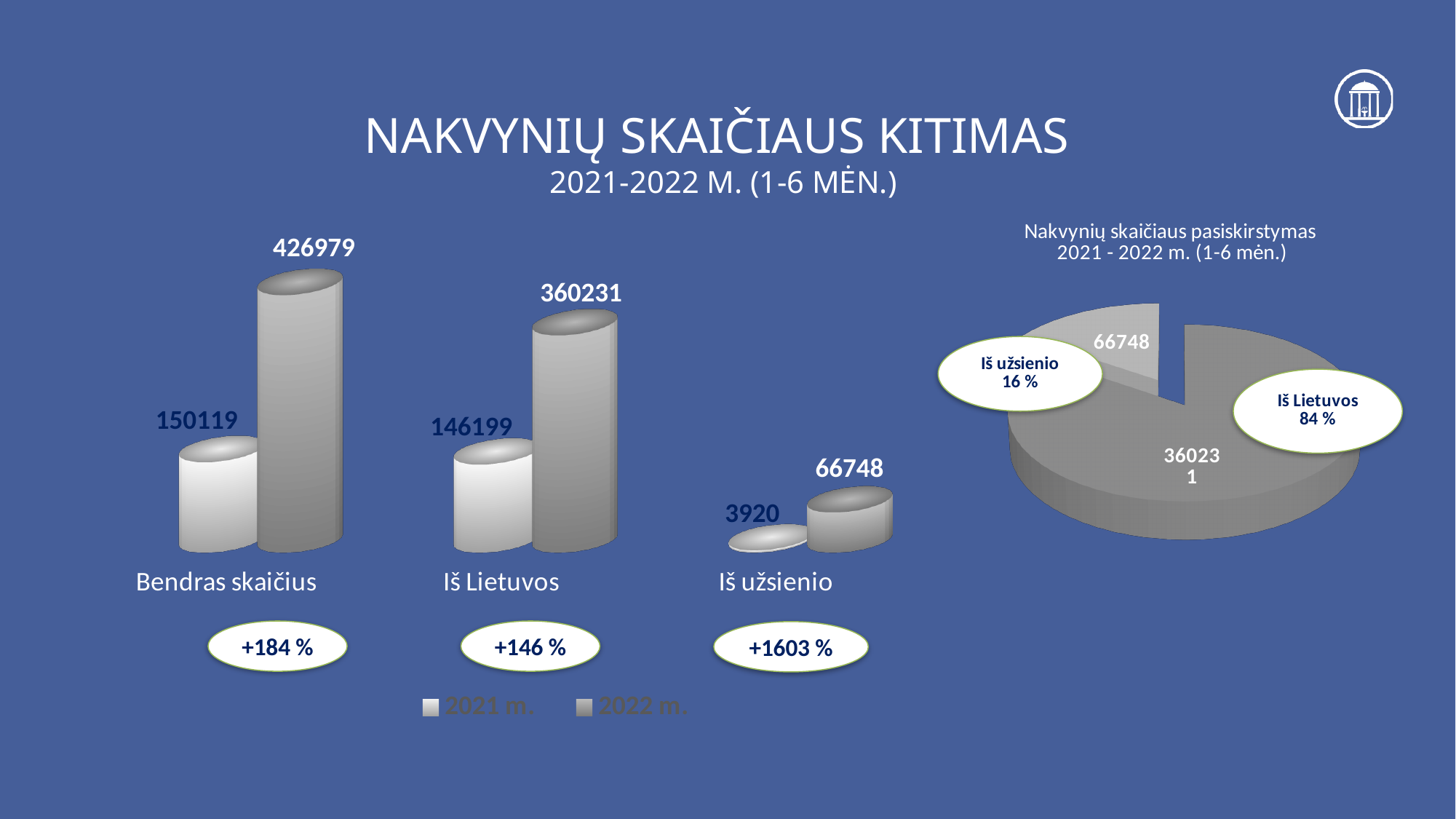
In the bar chart on the left, what is the difference between the 2022 m. and 2021 m. values for Bendras skaičius? 276860 In the bar chart on the left, which is larger: the 2022 m. value for Iš Lietuvos or the 2022 m. value for Iš užsienio? Iš Lietuvos How many categories does the bar chart on the left show? 3 In the bar chart on the left, what is the value for Iš Lietuvos in 2021 m.? 146199 How many series does the legend of the bar chart on the left list? 2 In the bar chart on the left, which category has the lowest 2021 m. value? Iš užsienio In the bar chart on the left, what is the value for Iš užsienio in 2021 m.? 3920 In the pie chart on the right, what is the value shown for the Iš užsienio slice? 66748 In the bar chart on the left, what is the value for Bendras skaičius in 2022 m.? 426979 In the pie chart on the right, what share does Iš Lietuvos have? 84 % In the bar chart on the left, which category has the highest 2022 m. value? Bendras skaičius What kind of chart is the chart on the right of the slide? Pie chart